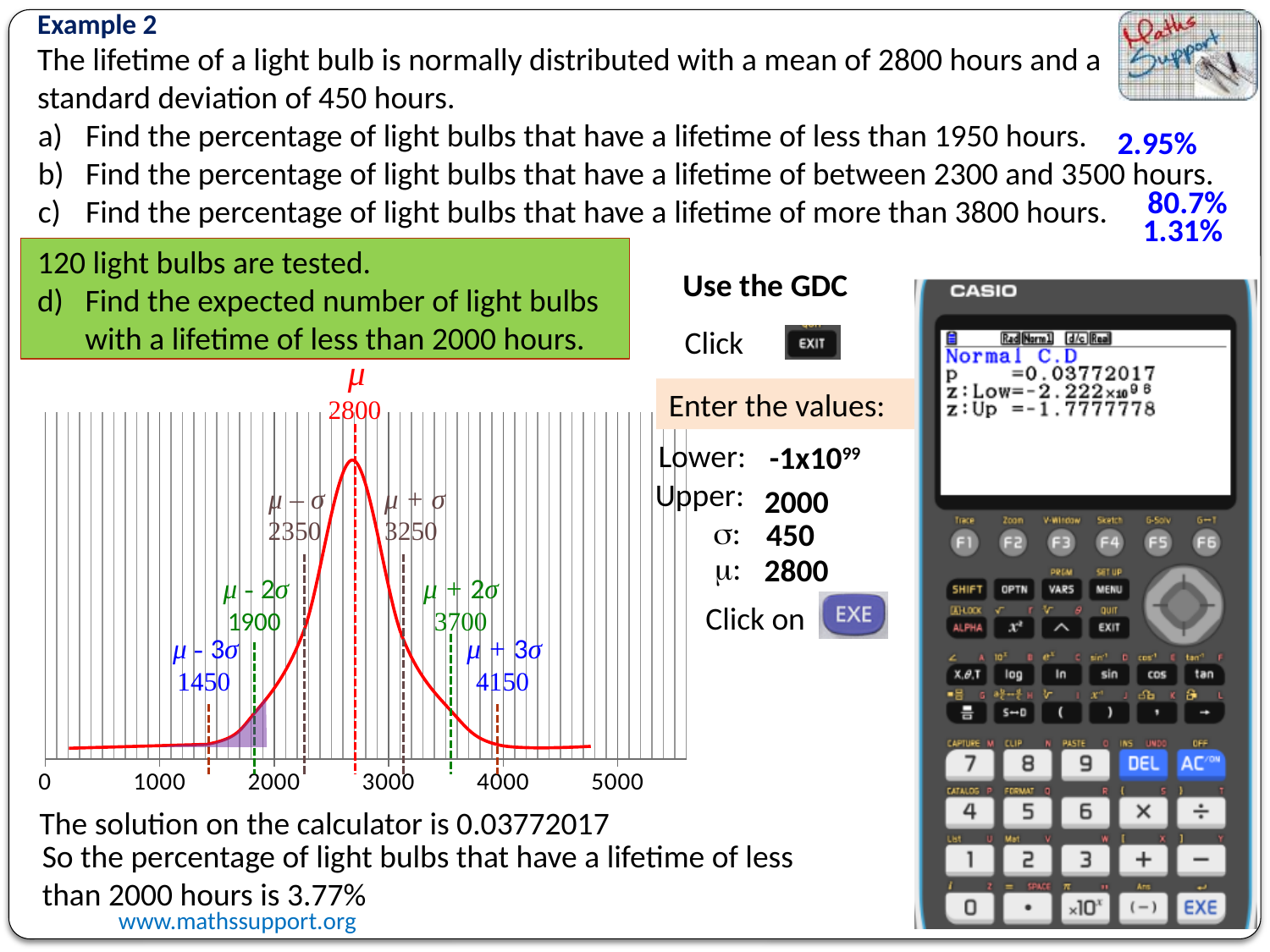
What is the difference between the values labelled at μ + 3σ and μ − 3σ on the chart? 2700 Does the curve rise or fall as x increases from 1000 to 2800? rise What value is labelled at μ + σ on the chart? 3250 What value is labelled at μ − 2σ on the chart? 1900 What value is labelled at μ − 3σ on the chart? 1450 What is the difference between the values labelled at μ + σ and μ − σ on the chart? 900 What value is labelled at μ + 3σ on the chart? 4150 At which labelled x value does the curve reach its highest point? 2800 What kind of chart is shown on the slide? line chart Is the curve higher at 2800 or at 4000? 2800 What value is labelled at μ on the chart? 2800 What colour is the curve on the chart? red